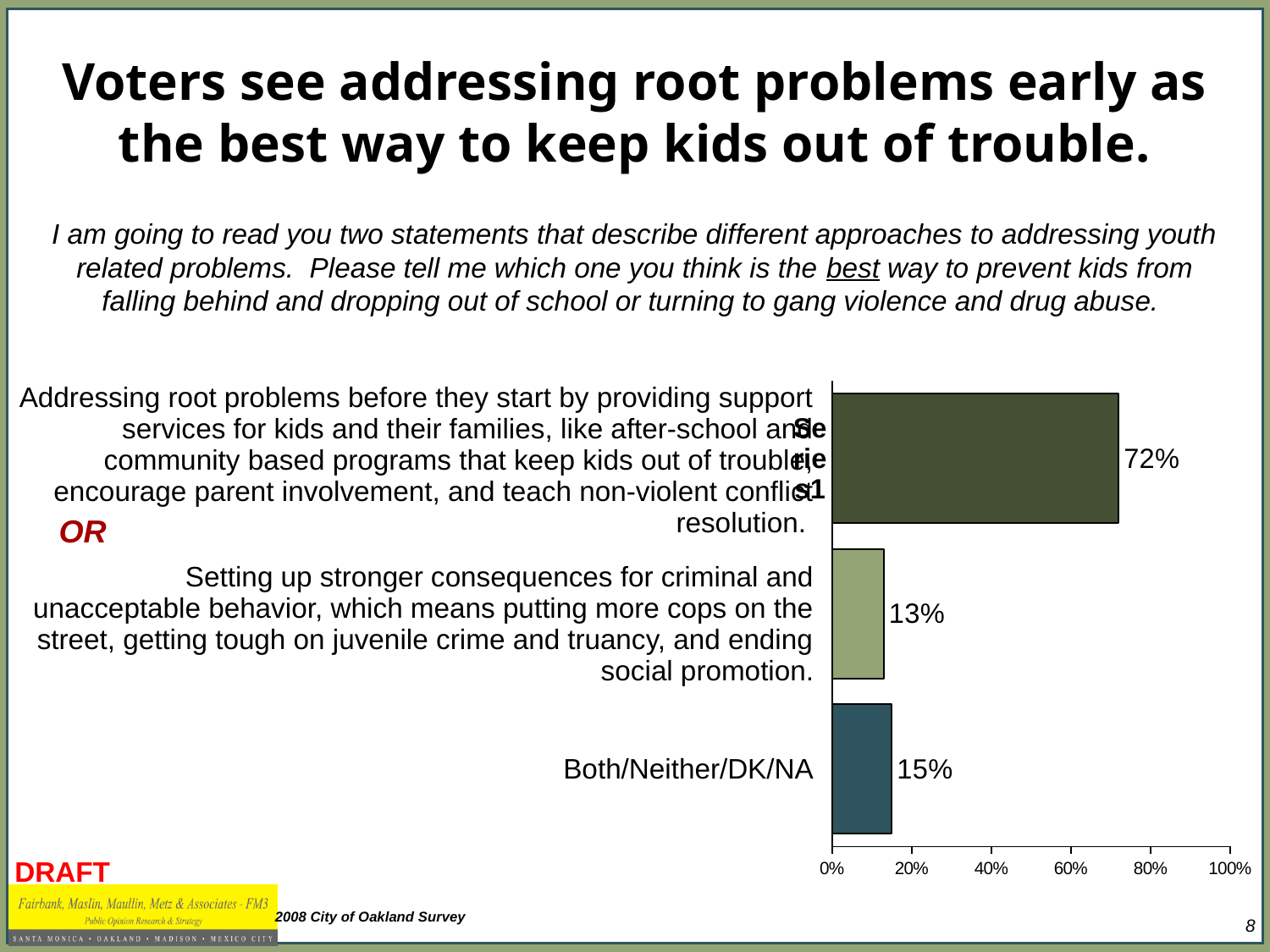
How many response categories are shown in the chart? 3 What is the difference between the Both/Neither/DK/NA value and the setting up stronger consequences value? 2 percentage points Which response option has the highest percentage? Addressing root problems before they start What is the highest value shown on the chart's percentage axis? 100% Which is larger: the value for Both/Neither/DK/NA or the value for setting up stronger consequences? Both/Neither/DK/NA What is the value shown for Both/Neither/DK/NA? 15% What type of chart is shown on the slide? Bar chart What is the difference in percentage points between addressing root problems and setting up stronger consequences? 59 percentage points Is the value for addressing root problems greater or less than 60%? greater What percentage of voters chose addressing root problems before they start as the best approach? 72% Which response option has the lowest percentage? Setting up stronger consequences What percentage of voters chose setting up stronger consequences for criminal and unacceptable behavior? 13%